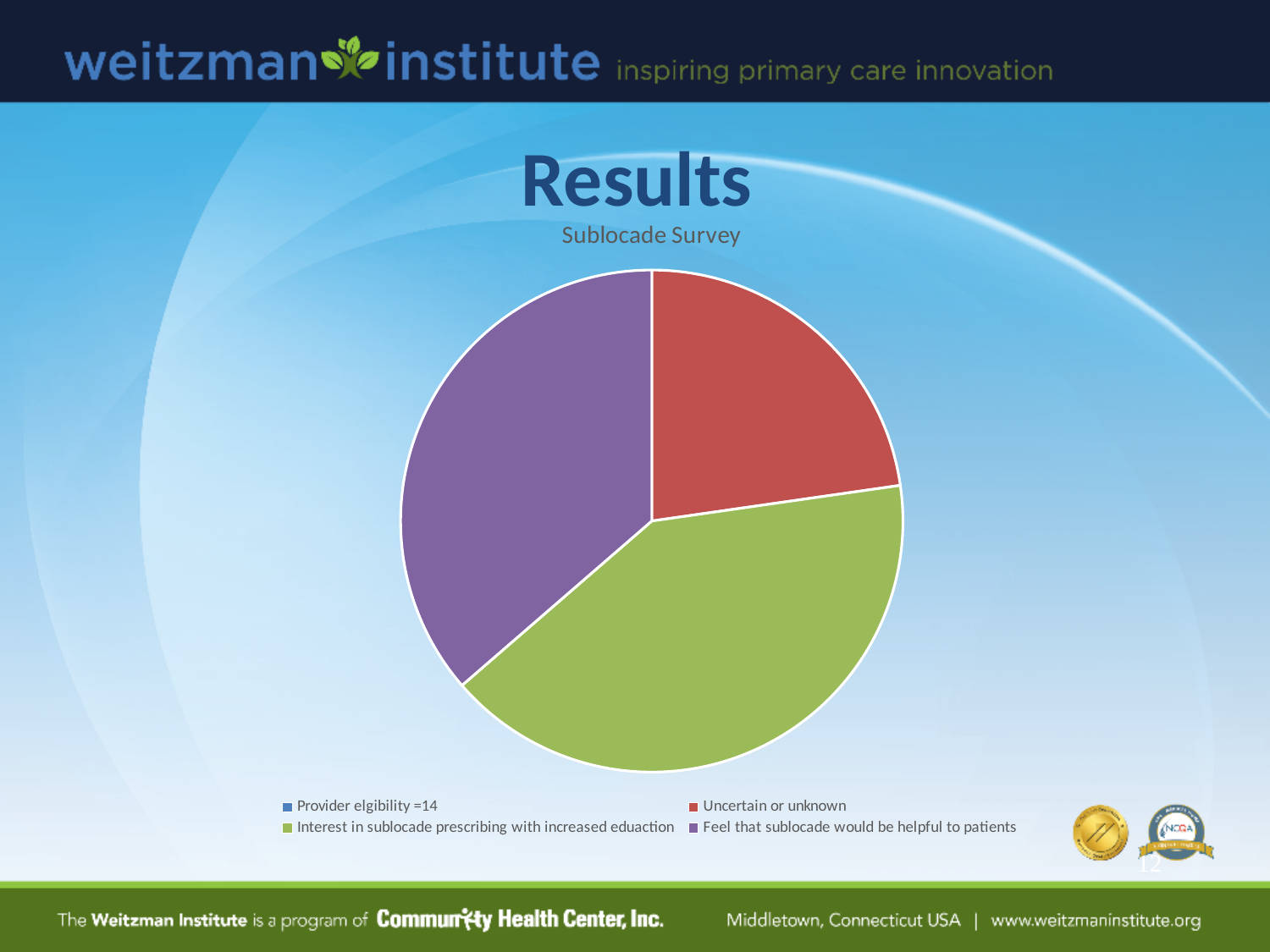
What kind of chart is shown on the slide? pie chart Which slice is larger: 'Uncertain or unknown' or 'Feel that sublocade would be helpful to patients'? Feel that sublocade would be helpful to patients What is the title of the chart? Sublocade Survey How many slices are visible in the pie chart? 3 How many entries does the chart's legend list? 4 Which legend entry is shown in red? Uncertain or unknown What colour is the slice for 'Feel that sublocade would be helpful to patients'? purple Which category has the smallest slice in the pie chart? Uncertain or unknown Which slice is larger: 'Uncertain or unknown' or 'Interest in sublocade prescribing with increased eduaction'? Interest in sublocade prescribing with increased eduaction